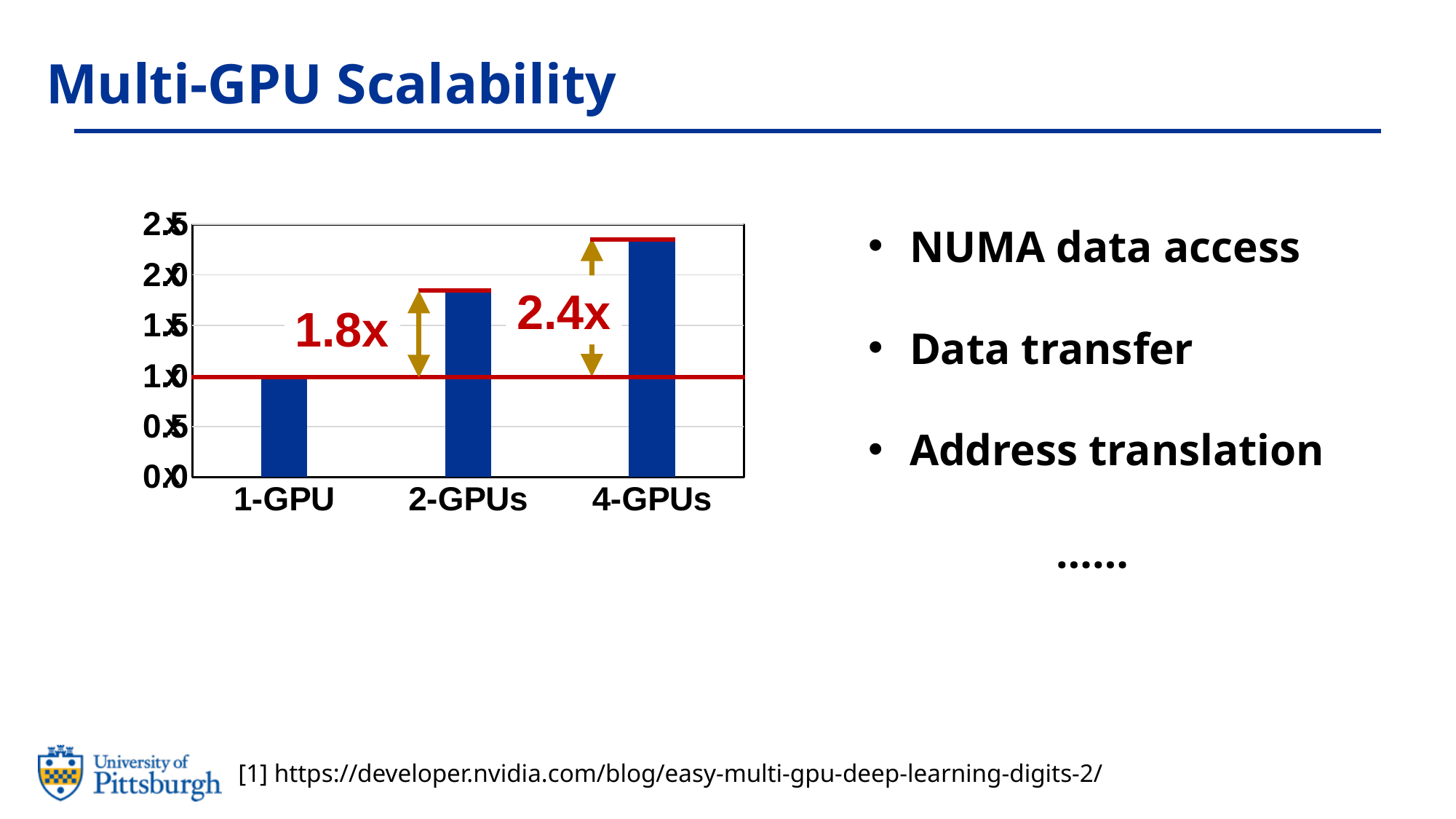
Do the bar values rise or fall from 1-GPU to 4-GPUs along the x axis? rise What speedup is annotated for 4-GPUs in the chart? 2.4x Which category has the highest bar in the chart? 4-GPUs Is the value for 2-GPUs greater or less than 1.5? greater How many categories are plotted on the x axis of the chart? 3 Which is larger, the bar for 2-GPUs or the bar for 4-GPUs? 4-GPUs What colour are the bars in the chart? blue What kind of chart is shown on the slide? bar chart What speedup is annotated for 2-GPUs in the chart? 1.8x Is the value for 4-GPUs greater or less than 2.0? greater Which category has the lowest bar in the chart? 1-GPU Is the value for 1-GPU greater or less than 1.5? less